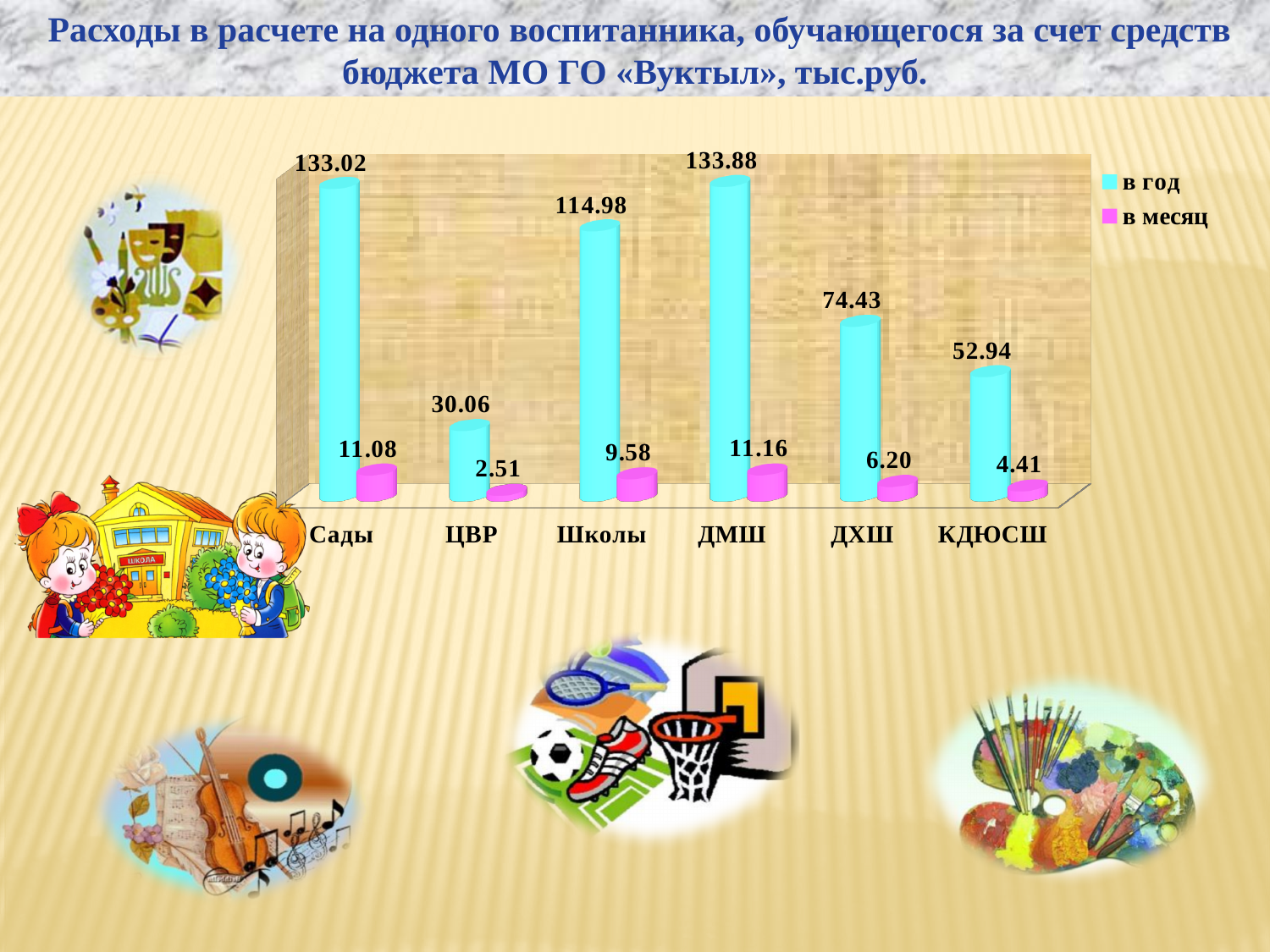
What is the difference between the 'в год' values for Сады and ЦВР? 102.96 Which category has the lowest 'в год' value? ЦВР How many categories are shown on the x axis? 6 What is the value for ДХШ in the 'в год' series? 74.43 What is the value for КДЮСШ in the 'в месяц' series? 4.41 Which category has the highest 'в год' value? ДМШ What is the difference between the 'в месяц' values for ДМШ and ДХШ? 4.96 Which is larger: the 'в год' value for Школы or for ДХШ? Школы What kind of chart is shown on the slide? Bar chart How many series does the legend list? 2 What is the value for ЦВР in the 'в месяц' series? 2.51 What is the value for Школы in the 'в год' series? 114.98